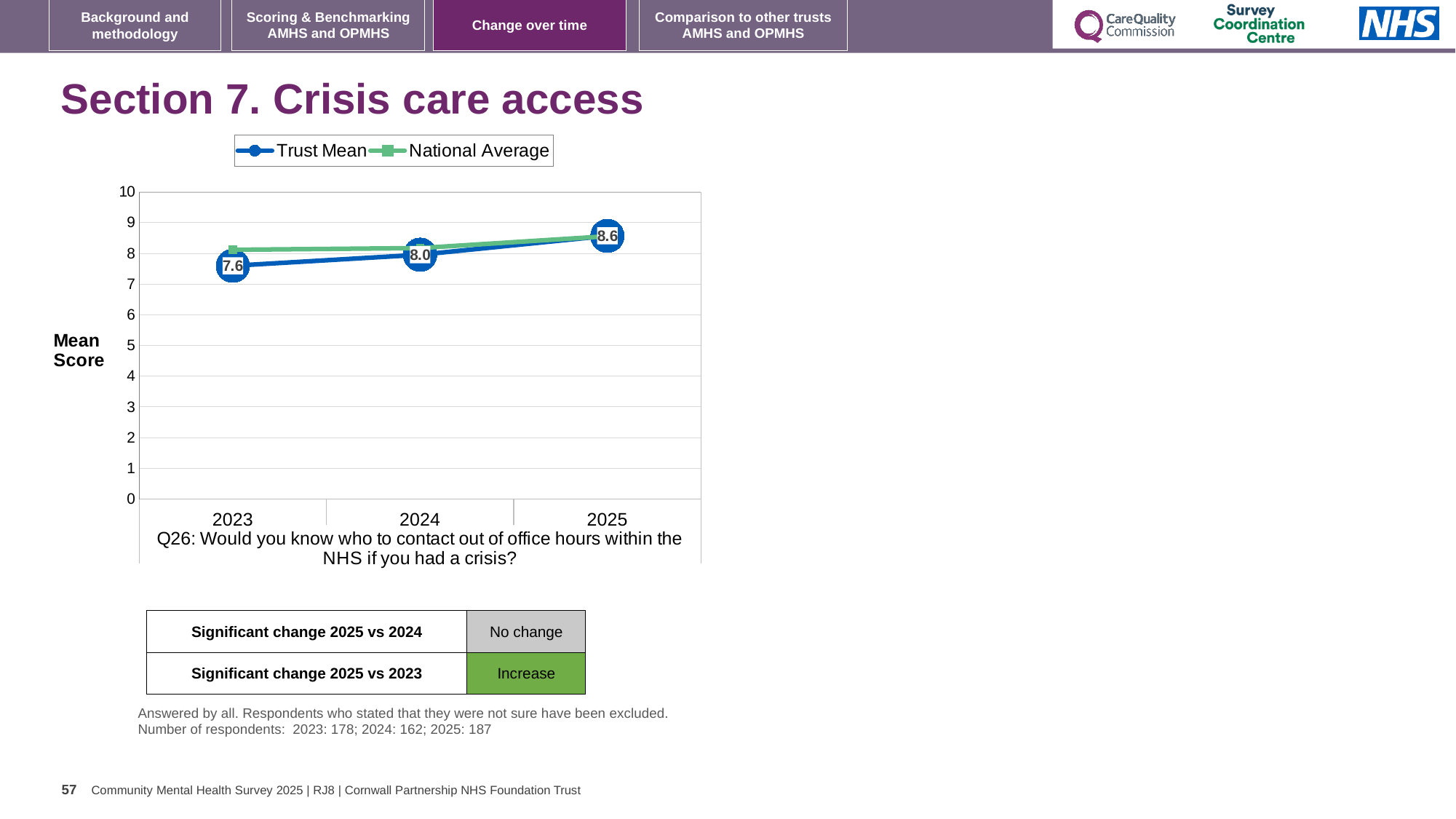
What is the Trust Mean score for 2025? 8.6 By how much did the Trust Mean increase from 2023 to 2025? 1.0 How many years are plotted on the x axis? 3 How many series does the legend list? 2 What kind of chart is shown on the slide? Line chart Is the National Average value for 2023 greater or less than 7? greater What is the difference between the Trust Mean in 2024 and in 2023? 0.4 Which is larger, the Trust Mean in 2025 or the Trust Mean in 2023? 2025 What is the Trust Mean score for 2023? 7.6 In which year is the Trust Mean lowest? 2023 What is the Trust Mean score for 2024? 8.0 In which year is the Trust Mean highest? 2025